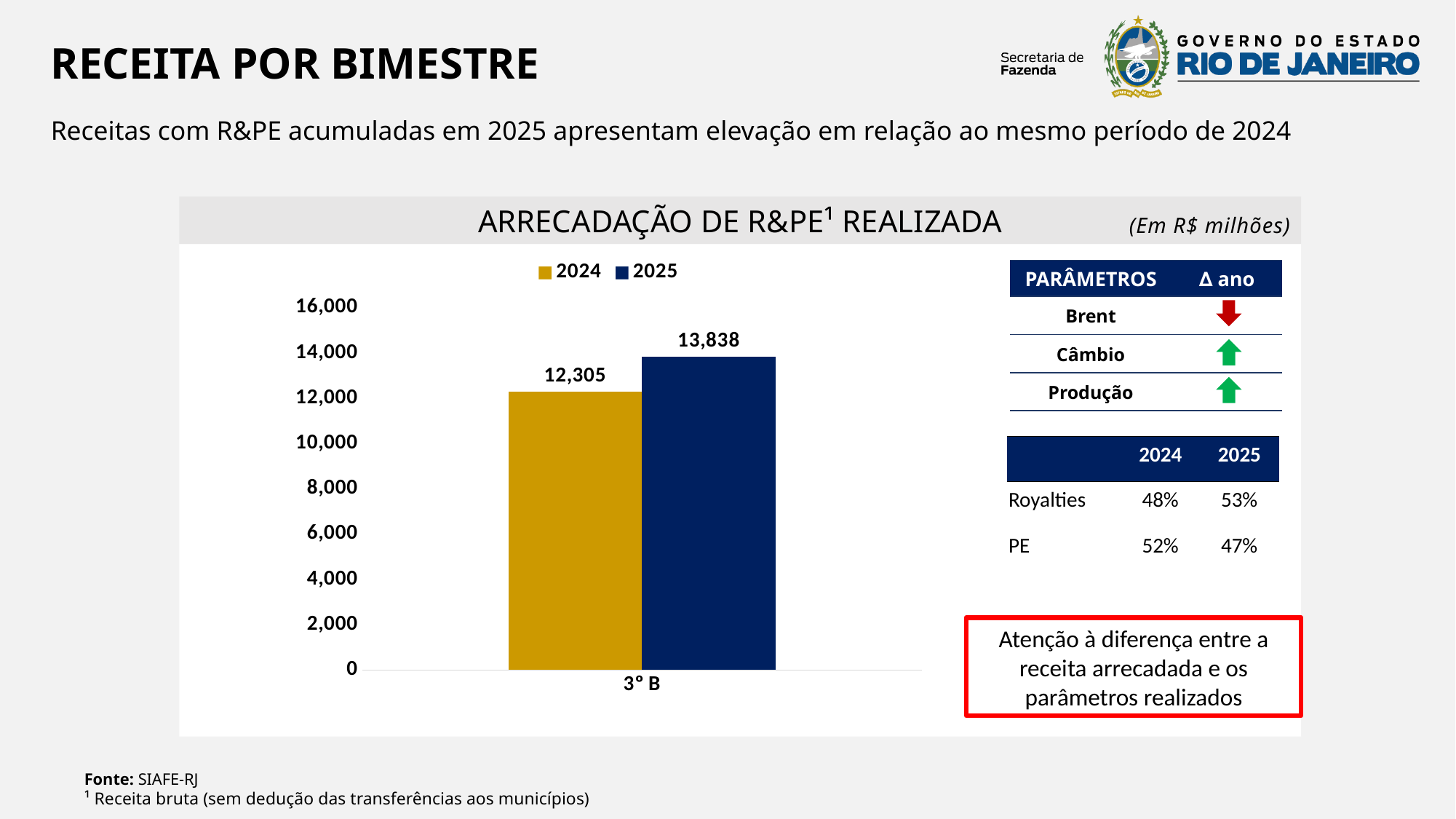
What is the value for 2024 in the 3° B category? 12,305 What is the maximum value shown on the y axis? 16,000 What is the difference between the 2025 and 2024 values for 3° B? 1,533 Is the value for 2024 greater or less than 14,000? less What is the title of the chart? ARRECADAÇÃO DE R&PE¹ REALIZADA How many categories are shown on the x axis? 1 Which series has the higher value for 3° B, 2024 or 2025? 2025 Which colour represents the 2025 series in the legend? dark blue How many series does the legend list? 2 Is the value for 2025 greater or less than 12,000? greater What kind of chart is shown? bar chart What is the value for 2025 in the 3° B category? 13,838